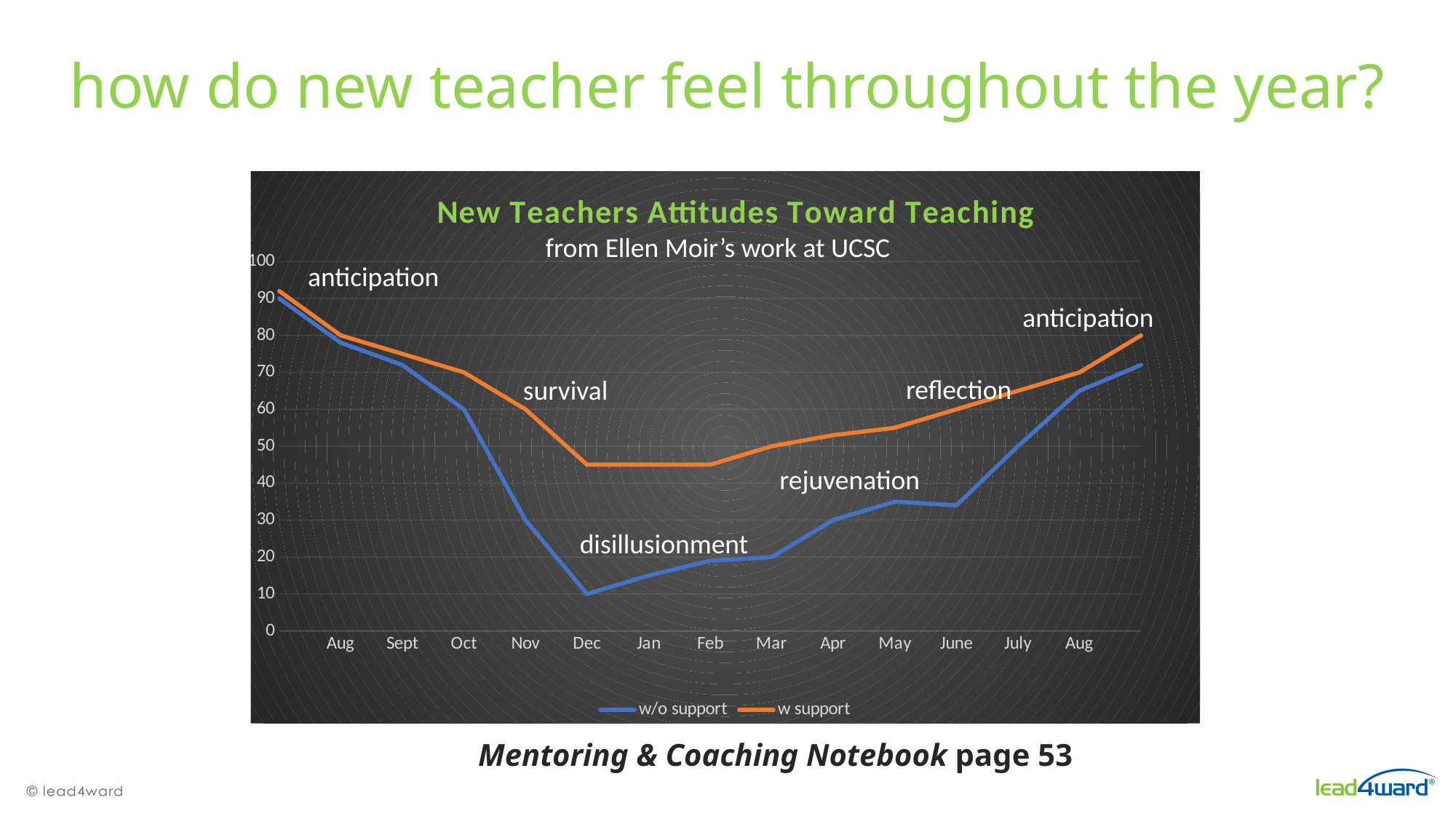
How many series does the chart legend list? 2 What is the title of the chart? New Teachers Attitudes Toward Teaching How many month labels are shown along the x axis? 13 Is the value for w support in Dec greater or less than 40? greater In which labeled month does the w/o support line reach its lowest point? Dec What are the two series named in the chart legend? w/o support and w support Is the value for w/o support in May greater or less than 30? greater What kind of chart is shown on the slide? line chart Does the w support line rise or fall from Feb to the second Aug? rise In Nov, which series has the higher value, w/o support or w support? w support Does the w/o support line rise or fall from Aug to Dec? fall